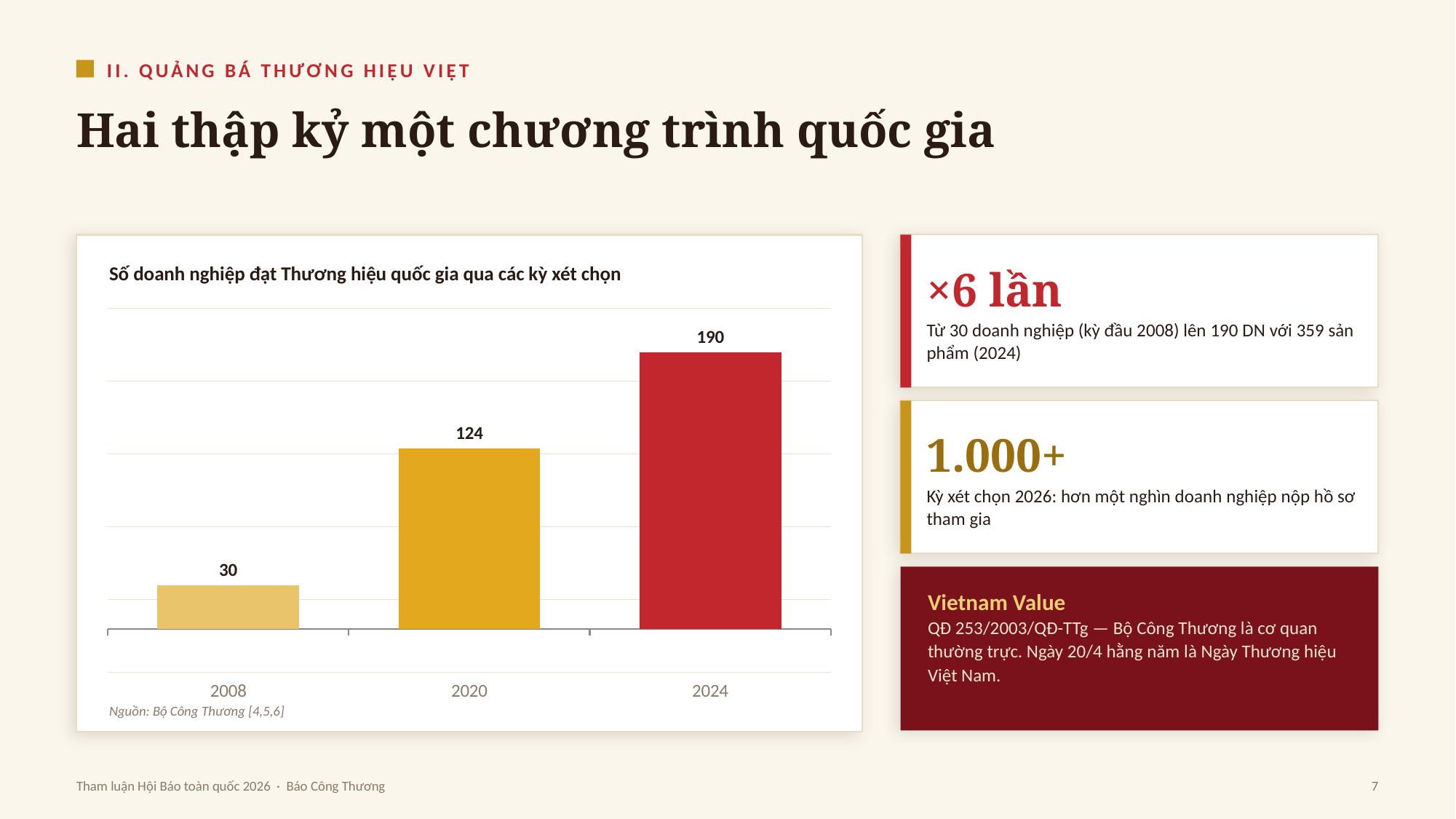
What is the value for 2020? 124 How many years are shown on the x axis? 3 Do the values rise or fall from 2008 to 2024? rise Which year has the highest value? 2024 Which is larger, the value for 2020 or the value for 2008? 2020 What is the difference between the values for 2024 and 2020? 66 What kind of chart is shown? bar chart What is the value for 2008? 30 Which year has the lowest value? 2008 What is the difference between the values for 2020 and 2008? 94 What is the title of the chart? Số doanh nghiệp đạt Thương hiệu quốc gia qua các kỳ xét chọn What is the value for 2024? 190